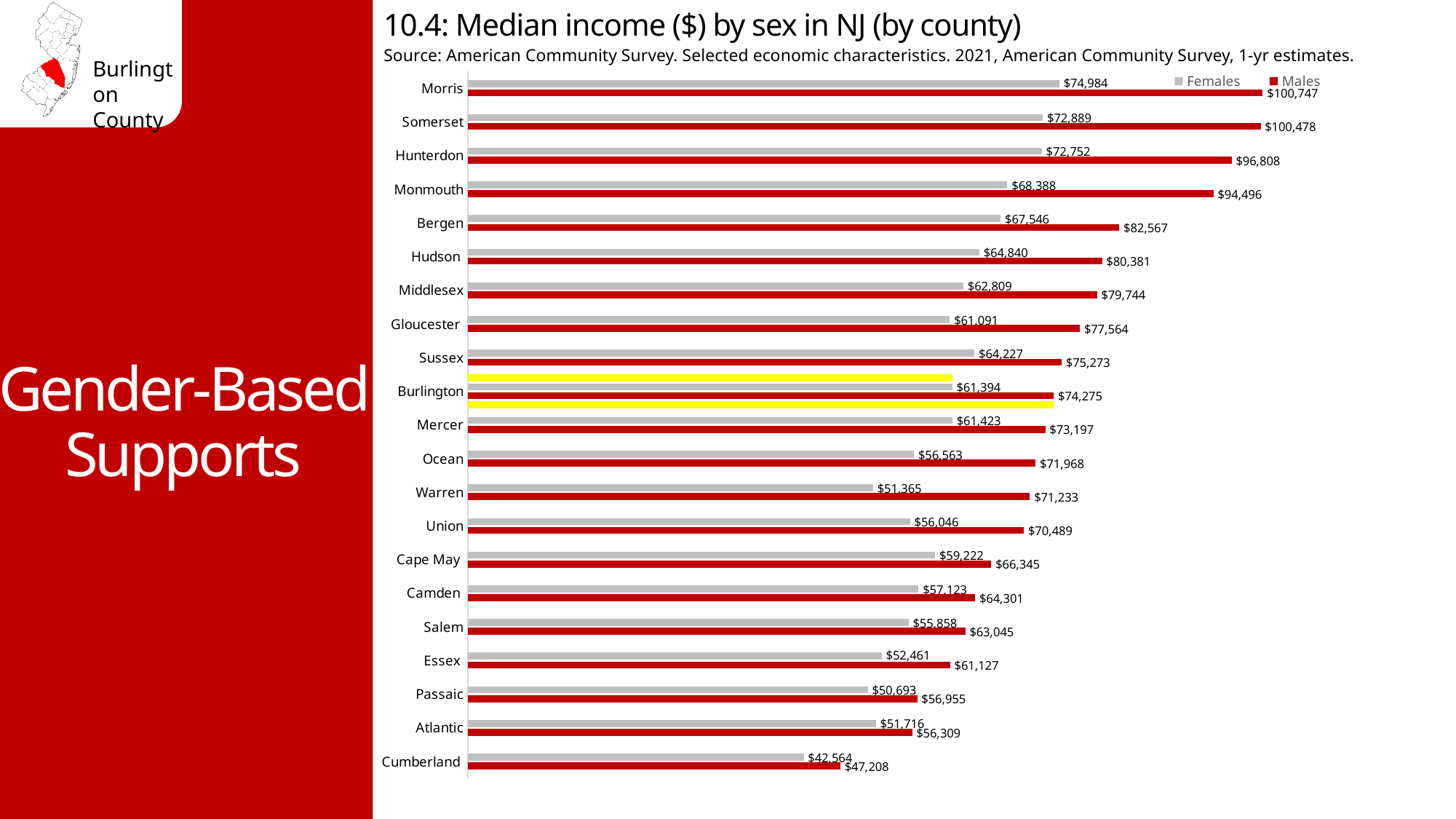
What is the median income for males in Hunterdon County? $96,808 What is the median income for males in Burlington County? $74,275 What kind of chart is shown on the slide? Bar chart How many series does the legend list? 2 Which is larger: the female median income in Sussex County or in Gloucester County? Sussex Which county has the lowest median income for males? Cumberland How many counties are shown in the chart? 21 What is the median income for females in Cumberland County? $42,564 What is the median income for females in Burlington County? $61,394 What is the difference between male and female median income in Burlington County? $12,881 What is the difference between male and female median income in Morris County? $25,763 Which county has the highest median income for females? Morris